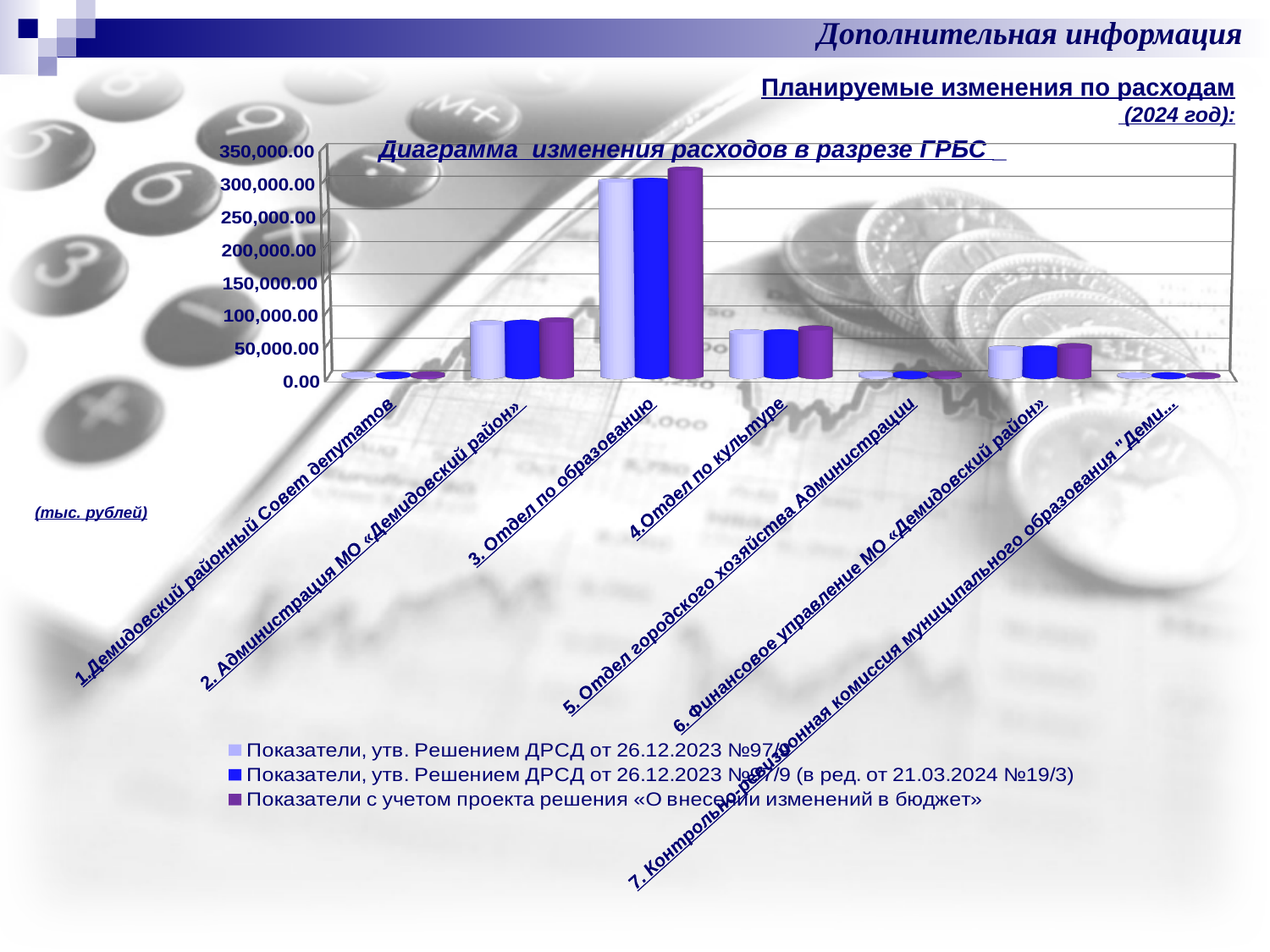
Is the value for «6. Финансовое управление МО «Демидовский район»» in the series «Показатели, утв. Решением ДРСД от 26.12.2023 №97/9» greater or less than 100,000.00? less Is the value for «4.Отдел по культуре» in the series «Показатели, утв. Решением ДРСД от 26.12.2023 №97/9» greater or less than 50,000.00? greater Which is larger: the value for «3. Отдел по образованию» or the value for «4.Отдел по культуре» in the series «Показатели с учетом проекта решения «О внесении изменений в бюджет»»? 3. Отдел по образованию How many series does the chart legend list? 3 Which is larger: the value for «2. Администрация МО «Демидовский район»» or the value for «6. Финансовое управление МО «Демидовский район»» in the series «Показатели, утв. Решением ДРСД от 26.12.2023 №97/9»? 2. Администрация МО «Демидовский район» What is the highest value shown on the vertical axis of the chart? 350,000.00 Which category has the highest values in the chart? 3. Отдел по образованию How many categories (ГРБС) are shown on the x axis of the chart? 7 What is the title of the chart? Диаграмма изменения расходов в разрезе ГРБС What kind of chart is shown on the slide? bar chart Is the value for «2. Администрация МО «Демидовский район»» in the series «Показатели, утв. Решением ДРСД от 26.12.2023 №97/9» greater or less than 100,000.00? less